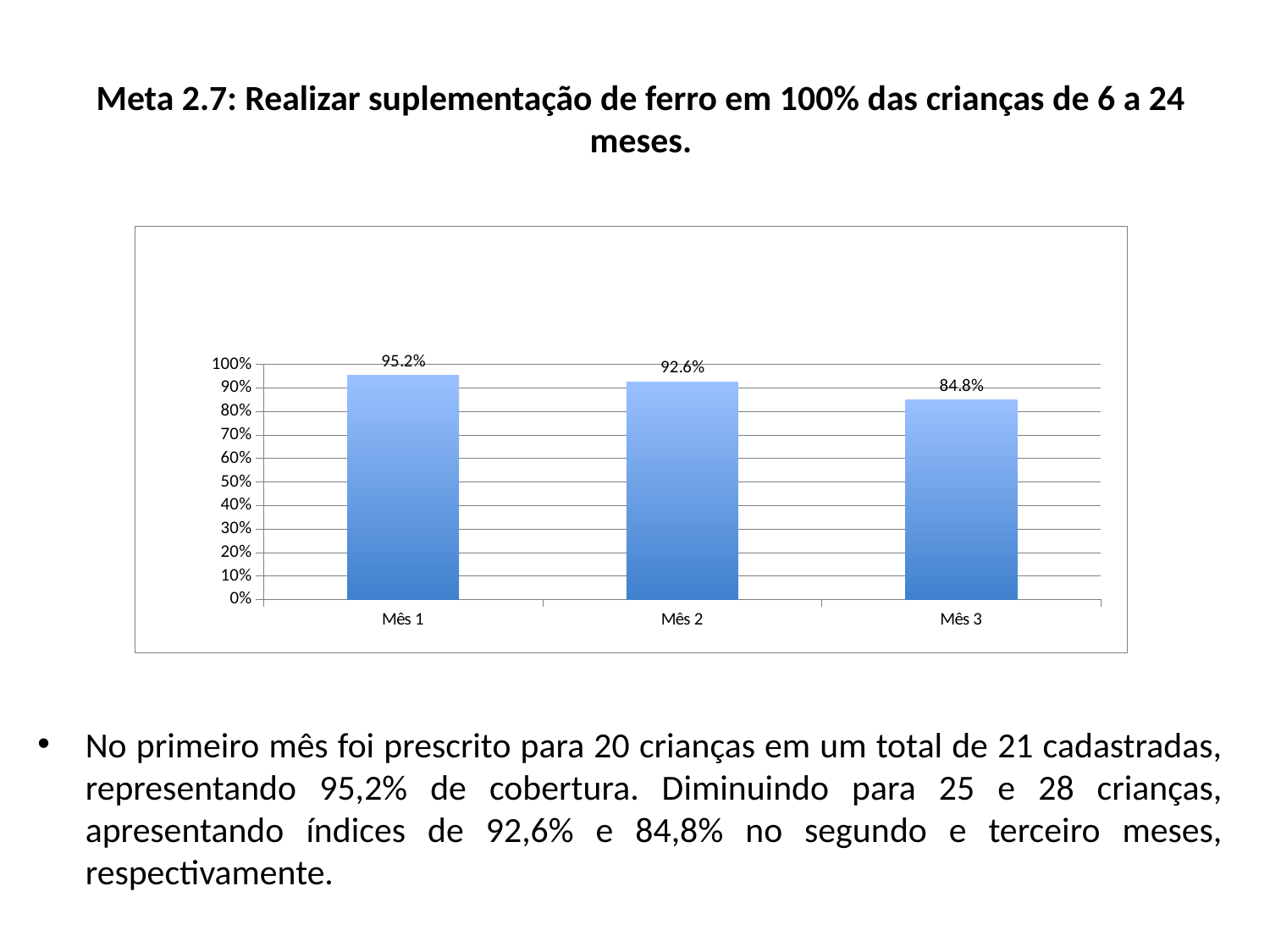
Which is larger, the value for Mês 1 or the value for Mês 2? Mês 1 Do the values rise or fall from Mês 1 to Mês 3? fall What is the difference between the values for Mês 2 and Mês 3? 7.8% What is the value for Mês 3? 84.8% What is the value for Mês 1? 95.2% What is the difference between the values for Mês 1 and Mês 3? 10.4% Is the value for Mês 3 greater or less than 90%? less How many categories are shown on the x axis? 3 What kind of chart is shown on the slide? bar chart Which month has the lowest value? Mês 3 What is the value for Mês 2? 92.6% Which month has the highest value? Mês 1